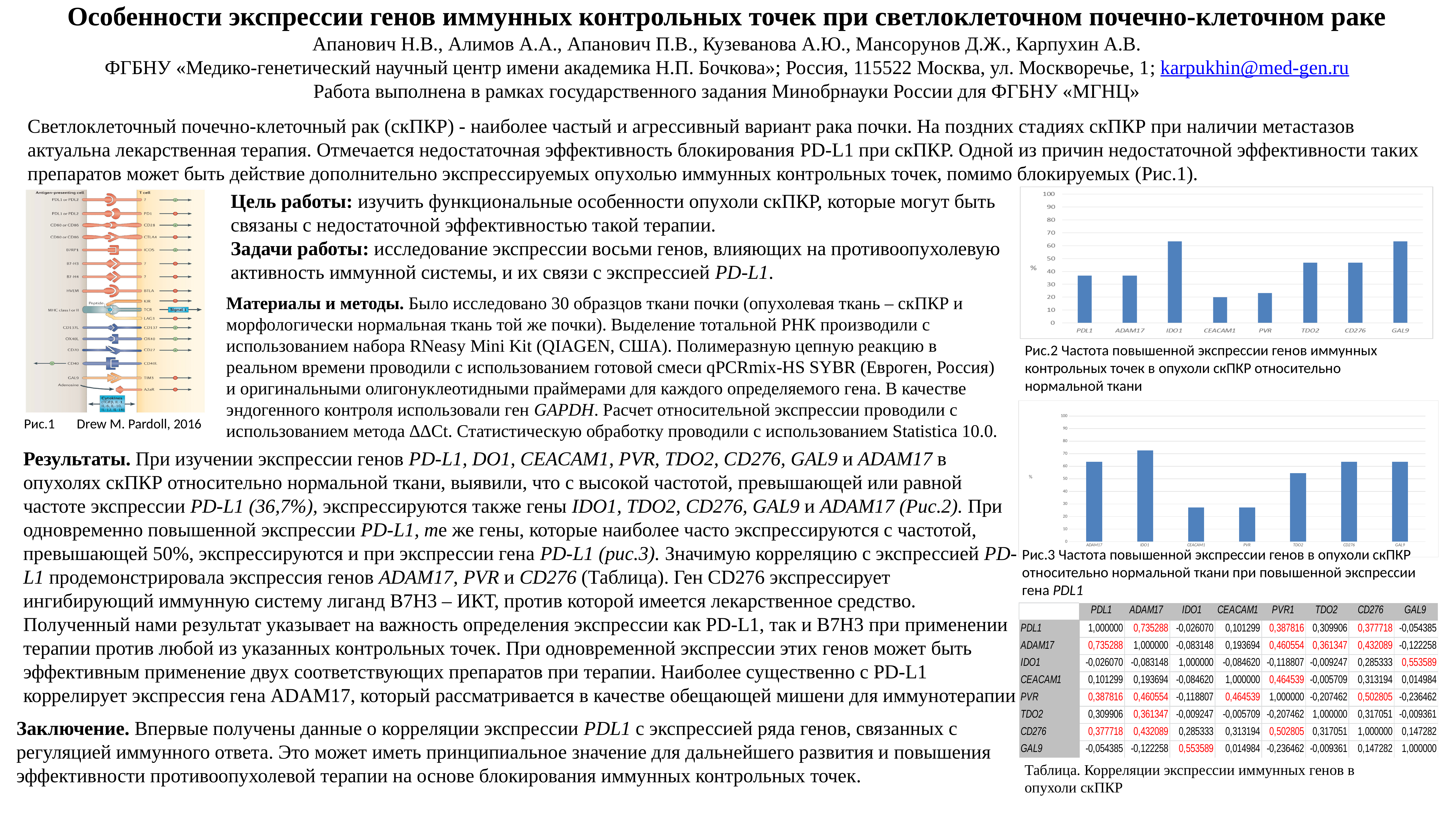
In Рис.2, is the value for IDO1 greater or less than 60? greater In Рис.3, which bar is taller, IDO1 or TDO2? IDO1 In Рис.3, is the value for CEACAM1 greater or less than 40? less In Рис.2, is the value for CEACAM1 greater or less than 30? less How many genes (categories) are shown on the x axis of Рис.2? 8 What kind of chart is Рис.2 (the upper chart on the right)? bar chart What is the label on the vertical axis of Рис.2? % How many genes (categories) are shown on the x axis of Рис.3? 7 In Рис.2, which bar is taller, IDO1 or CEACAM1? IDO1 In Рис.3, which gene has the highest bar? IDO1